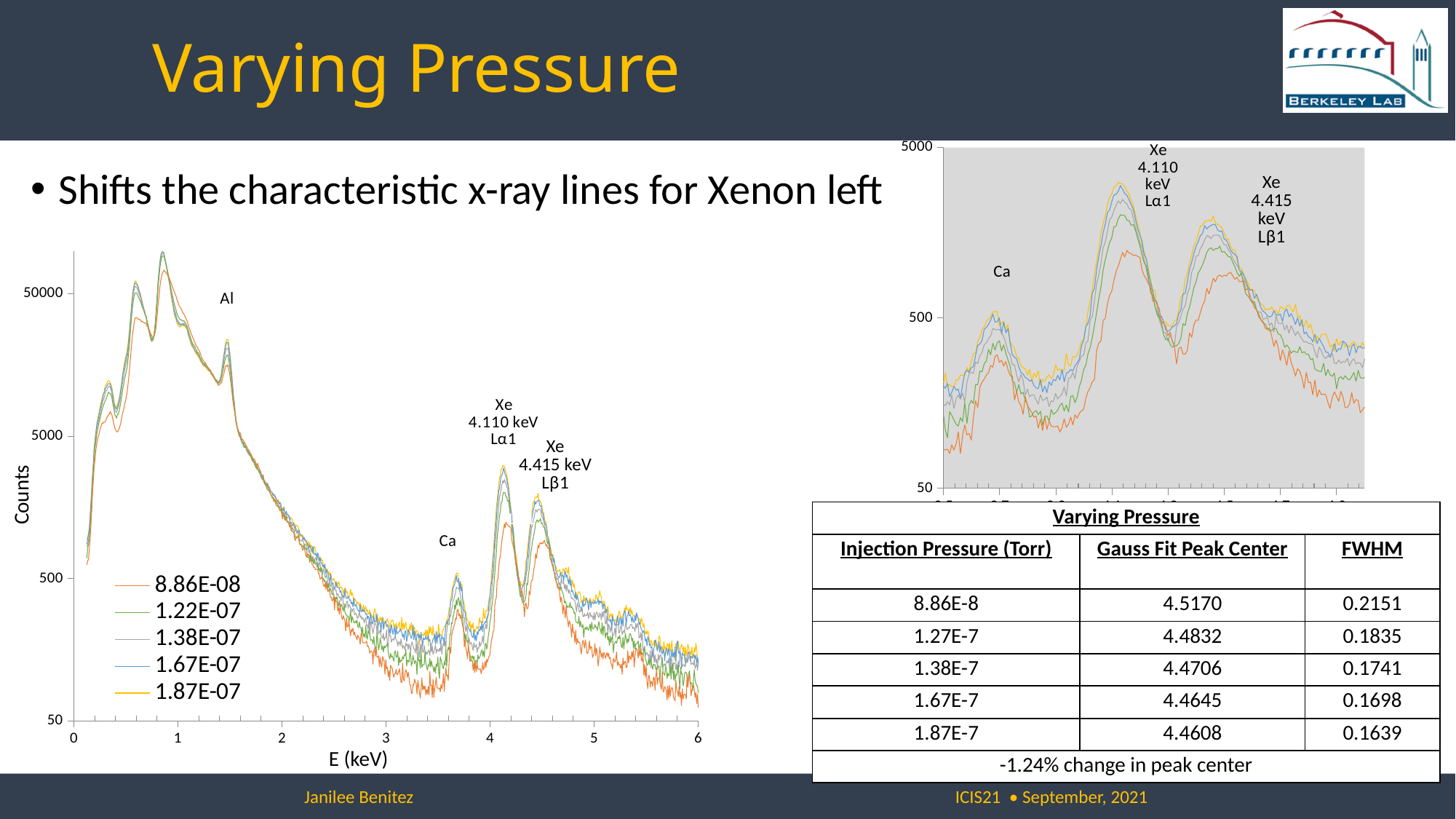
On the left chart, is the peak count of the Xe Lα1 line near 4.1 keV greater or less than 5000? less What is the x-axis label of the left chart? E (keV) On the left chart, do the counts rise or fall as energy increases from 2 keV to 3 keV? fall According to the annotation on the left chart, at what energy is the Xe Lβ1 line? 4.415 keV What kind of chart is the large chart on the left of the slide? line chart According to the annotation on the right chart, at what energy is the Xe Lα1 line? 4.110 keV On the left chart, is the Al peak near 1.5 keV greater or less than 50000 counts? less What are the legend entries of the left chart? 8.86E-08, 1.22E-07, 1.38E-07, 1.67E-07, 1.87E-07 On the left chart, is the highest peak near 0.9 keV greater or less than 50000 counts? greater On the left chart, which series has the lowest counts at the Xe Lα1 peak near 4.1 keV? 8.86E-08 How many series does the legend of the left chart list? 5